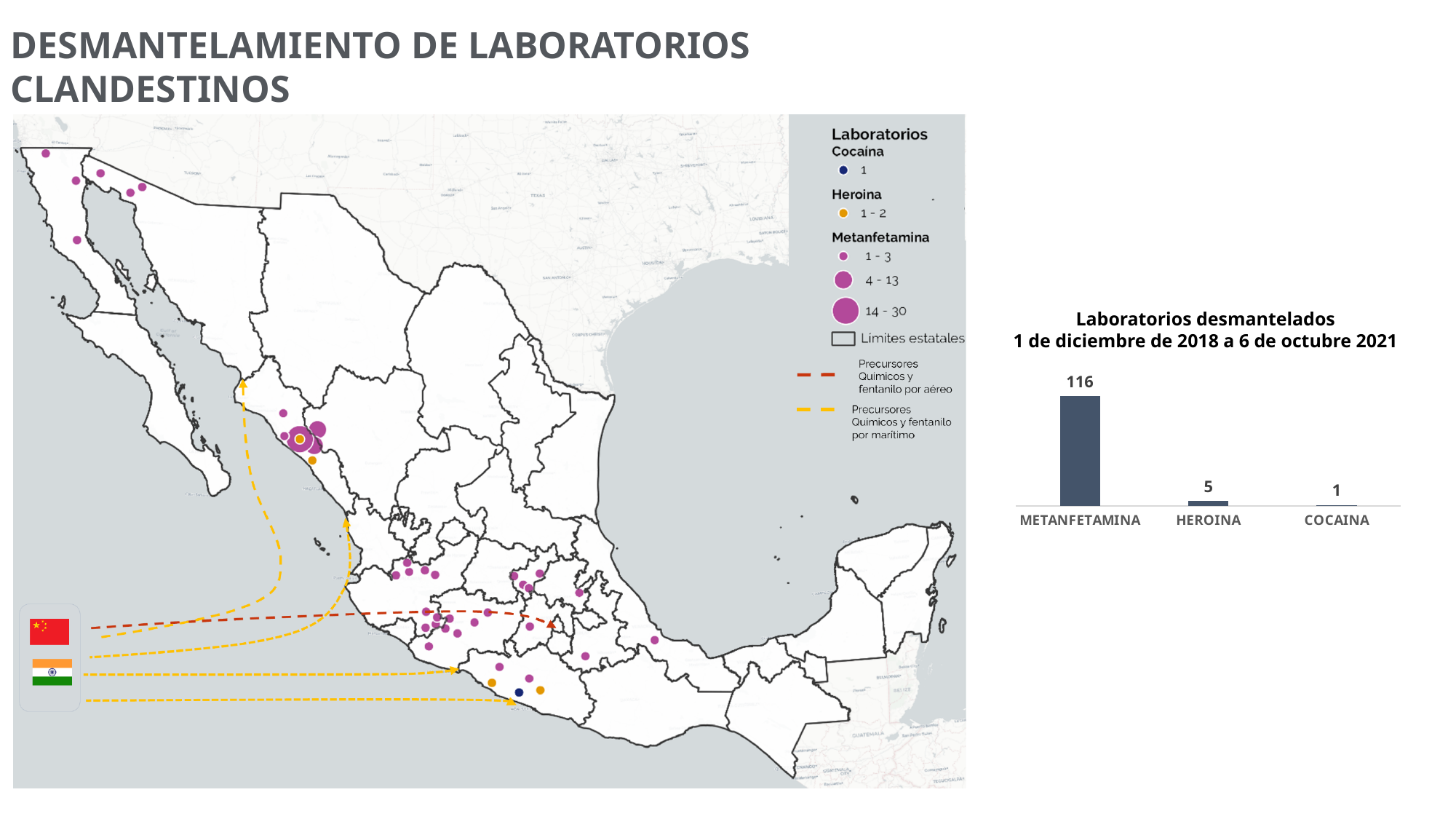
In the bar chart 'Laboratorios desmantelados', what is the difference between the values for METANFETAMINA and HEROINA? 111 In the bar chart 'Laboratorios desmantelados', what is the value for HEROINA? 5 In the bar chart 'Laboratorios desmantelados', what is the value for COCAINA? 1 In the bar chart 'Laboratorios desmantelados', which category has the highest value? METANFETAMINA How many categories are shown in the bar chart 'Laboratorios desmantelados'? 3 What is the total of the three values shown in the bar chart 'Laboratorios desmantelados'? 122 In the bar chart 'Laboratorios desmantelados', what is the difference between the values for HEROINA and COCAINA? 4 In the bar chart 'Laboratorios desmantelados', which is larger, the value for HEROINA or the value for COCAINA? HEROINA What date range is given in the title of the bar chart on the right of the slide? 1 de diciembre de 2018 a 6 de octubre 2021 In the bar chart 'Laboratorios desmantelados', which category has the lowest value? COCAINA What kind of chart is 'Laboratorios desmantelados'? bar chart In the bar chart 'Laboratorios desmantelados', what is the value for METANFETAMINA? 116